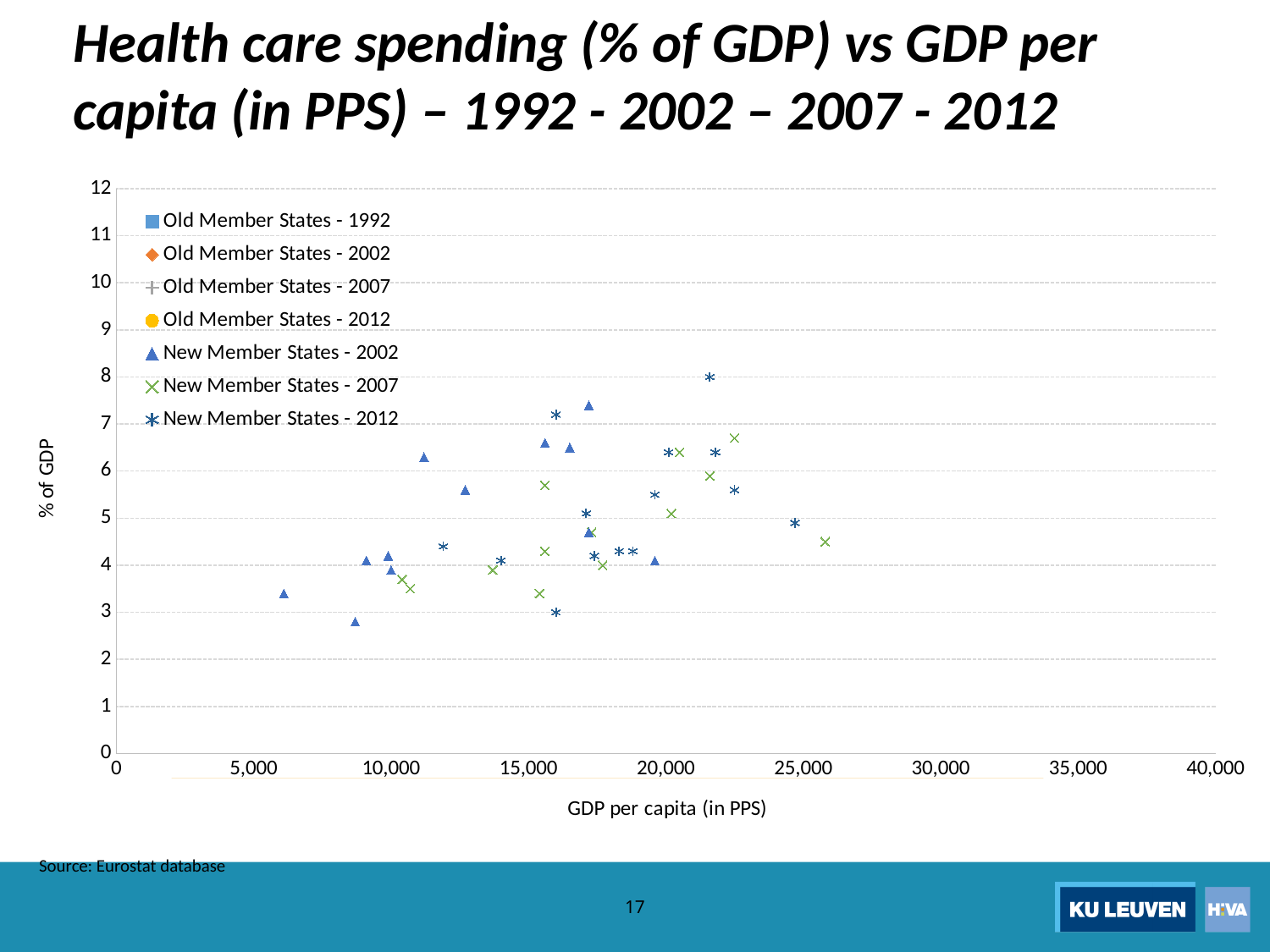
Is the GDP per capita of the rightmost plotted point greater or less than 25,000? greater Is the highest plotted value for New Member States - 2012 greater or less than 7 % of GDP? greater What is the title of the chart's horizontal axis? GDP per capita (in PPS) Which series does the point with the lowest GDP per capita belong to? New Member States - 2002 What kind of chart is shown on the slide? Scatter chart How many series does the chart legend list? 7 Which series does the highest plotted point on the chart belong to? New Member States - 2012 What is the maximum value shown on the horizontal axis? 40,000 Which series does the point with the highest GDP per capita belong to? New Member States - 2007 Is the % of GDP of the rightmost plotted point greater or less than 5? less What is the title of the chart's vertical axis? % of GDP